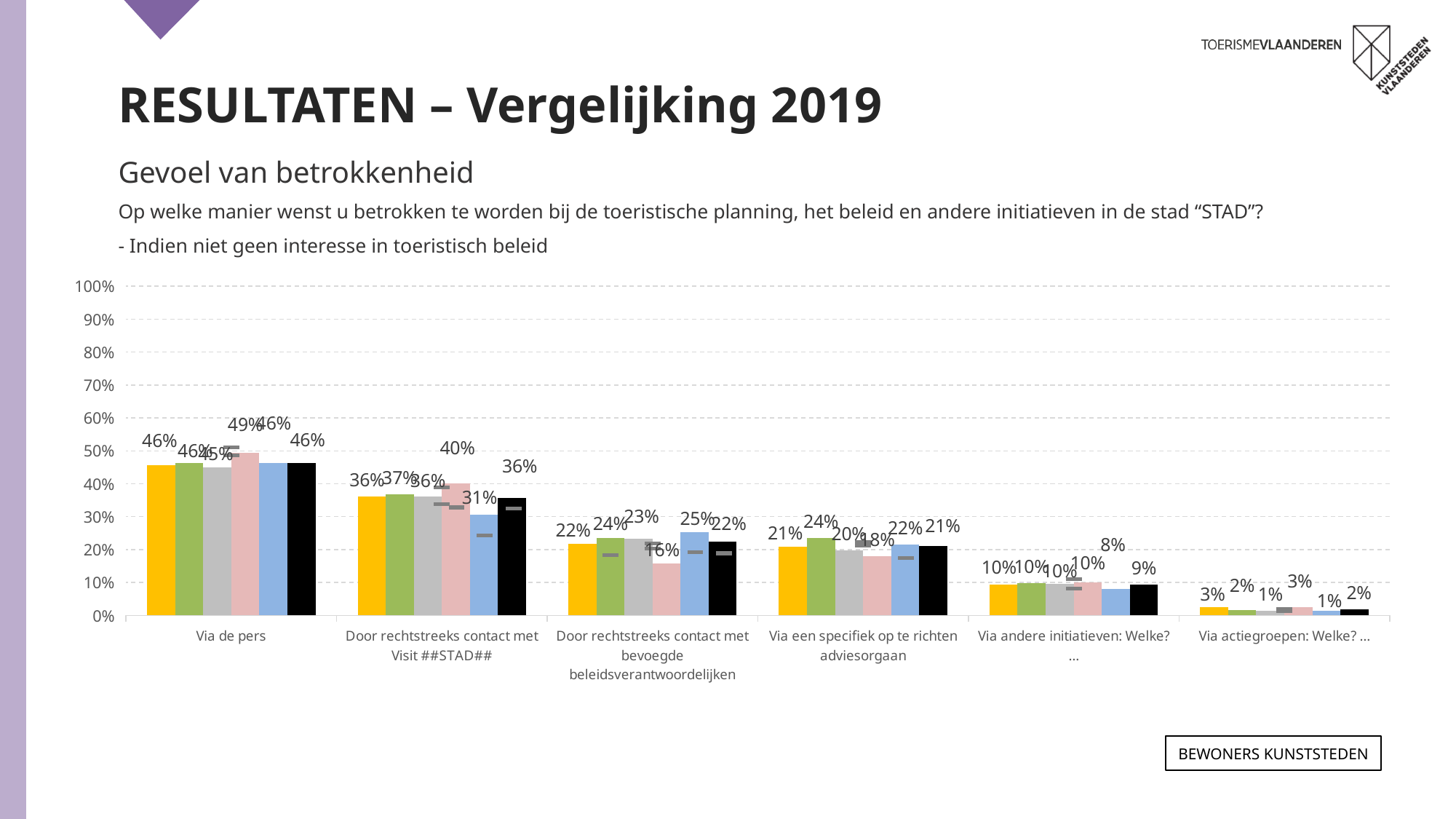
What is the value of the pink bar for 'Door rechtstreeks contact met bevoegde beleidsverantwoordelijken'? 16% What is the difference between the pink bar (40%) and the blue bar (31%) for 'Door rechtstreeks contact met Visit ##STAD##'? 9 percentage points Which category has the lowest values overall in the chart? Via actiegroepen: Welke? ... Which category has the highest values overall in the chart? Via de pers What type of chart is shown on the slide? bar chart What is the value of the black bar for 'Via andere initiatieven: Welke? ...'? 9% Is the value of the yellow bar for 'Via de pers' greater or less than 40%? greater For 'Door rechtstreeks contact met bevoegde beleidsverantwoordelijken', which is larger: the blue bar or the pink bar? the blue bar What is the value of the pink bar for 'Via de pers'? 49% What is the value of the blue bar for 'Door rechtstreeks contact met Visit ##STAD##'? 31% Do the values generally rise or fall moving from left to right along the x axis? fall How many categories are shown on the x axis of the chart? 6